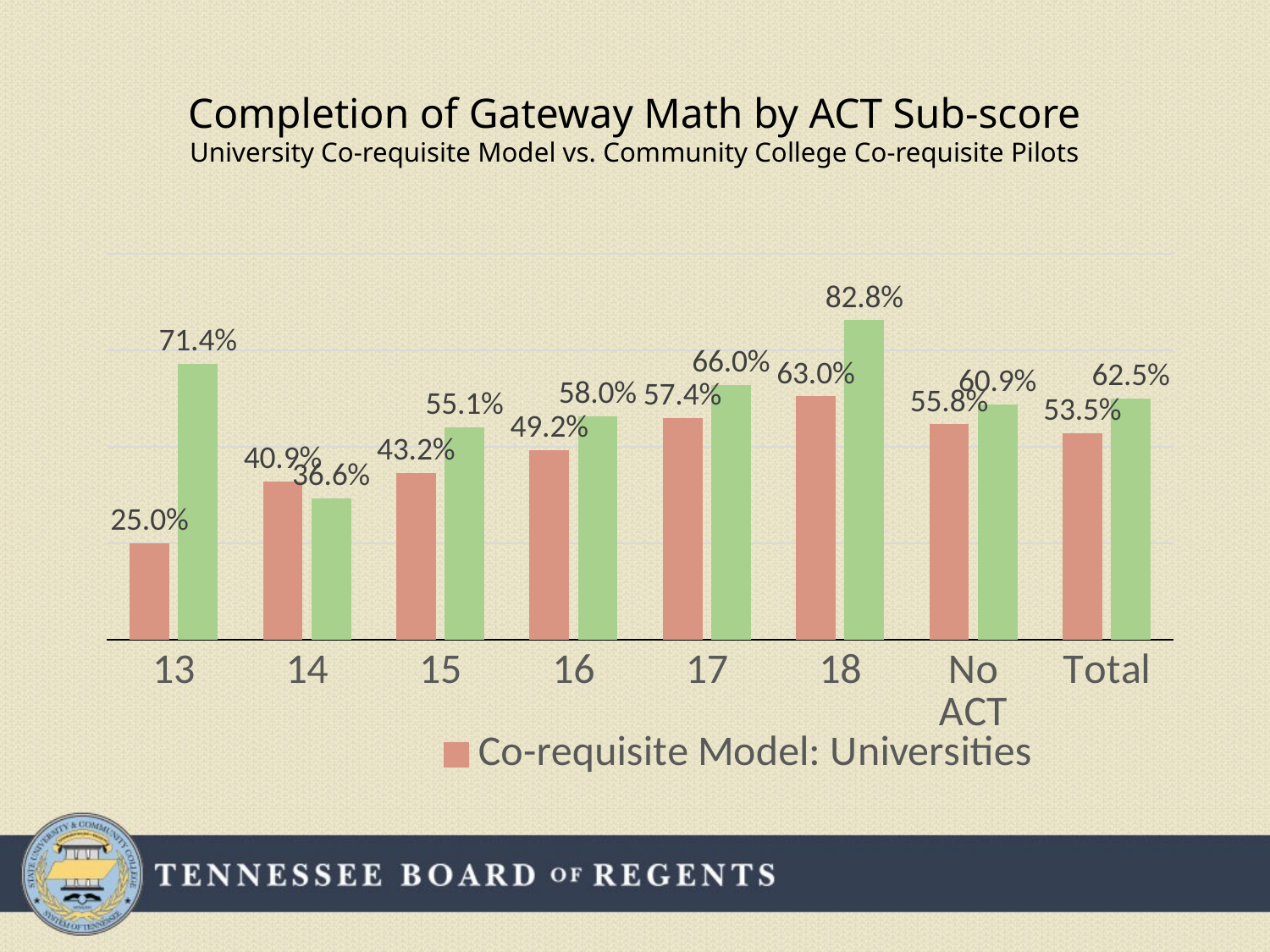
What value is shown on the green bar for the No ACT category? 60.9% What value is shown on the green bar for ACT sub-score 18? 82.8% For ACT sub-score 18, what is the difference between the green bar value and the Co-requisite Model: Universities value? 19.8 percentage points For ACT sub-score 14, which is larger: the Co-requisite Model: Universities bar or the green bar? Co-requisite Model: Universities Which category has the lowest Co-requisite Model: Universities value? 13 How many categories are shown on the x axis? 8 Which category has the highest green bar? 18 What is the Co-requisite Model: Universities value for ACT sub-score 13? 25.0% Which category has the highest Co-requisite Model: Universities value? 18 What is the Co-requisite Model: Universities value for the Total category? 53.5% Do the Co-requisite Model: Universities values rise or fall from ACT sub-score 13 to 18? Rise What kind of chart is shown on the slide? Bar chart